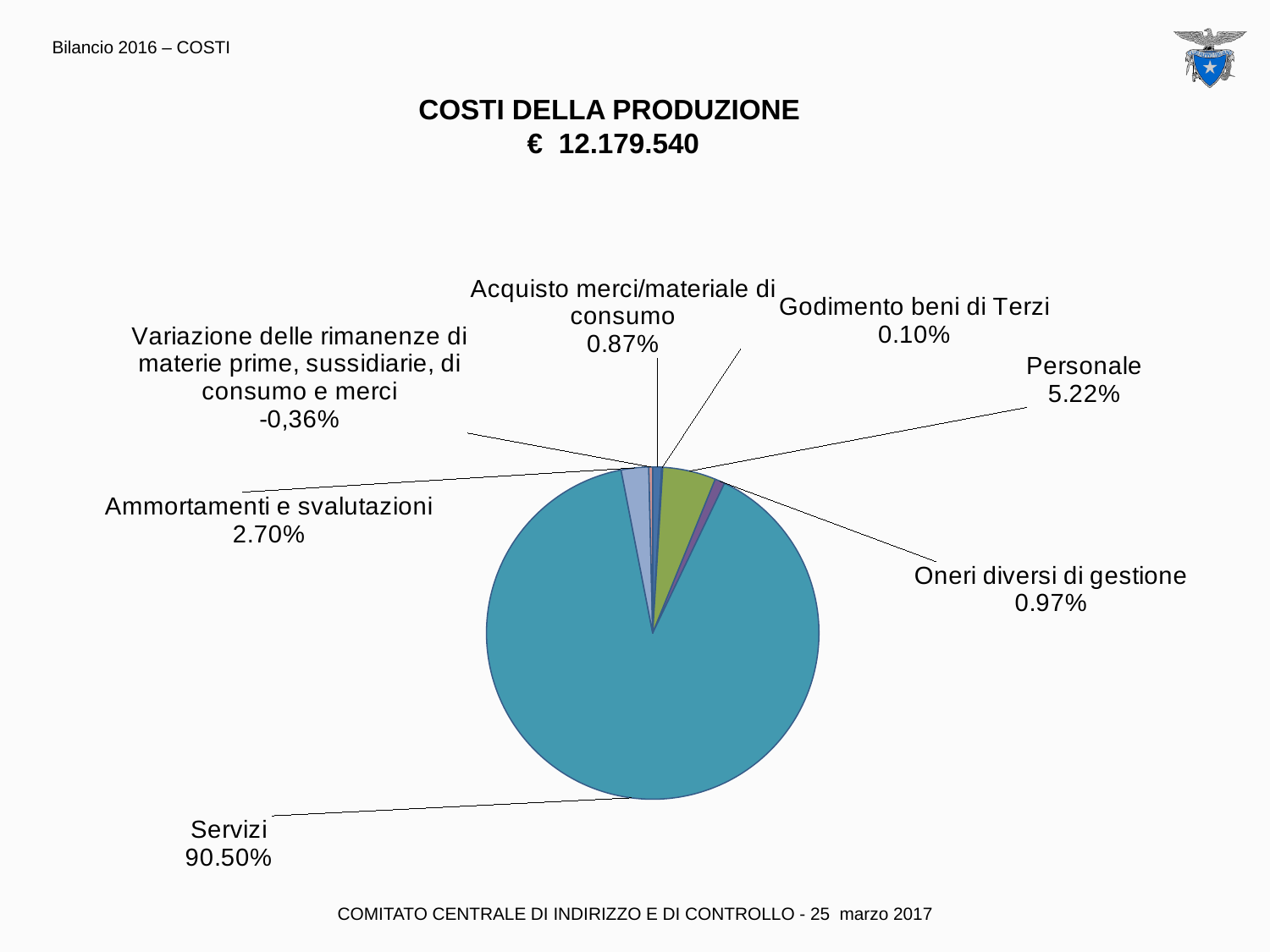
Which category has the smallest positive share of the pie? Godimento beni di Terzi Which category has the largest share of the pie? Servizi What is the value shown for Personale? 5.22% What is the value shown for Oneri diversi di gestione? 0.97% How many categories are shown in the pie chart? 7 What is the value shown for Ammortamenti e svalutazioni? 2.70% What is the value shown for Godimento beni di Terzi? 0.10% Which is larger, the share for Oneri diversi di gestione or the share for Acquisto merci/materiale di consumo? Oneri diversi di gestione What is the value shown for Acquisto merci/materiale di consumo? 0.87% What type of chart is shown on the slide? Pie chart What share of the pie does Servizi account for? 90.50% What is the difference between the shares of Personale and Ammortamenti e svalutazioni? 2.52%